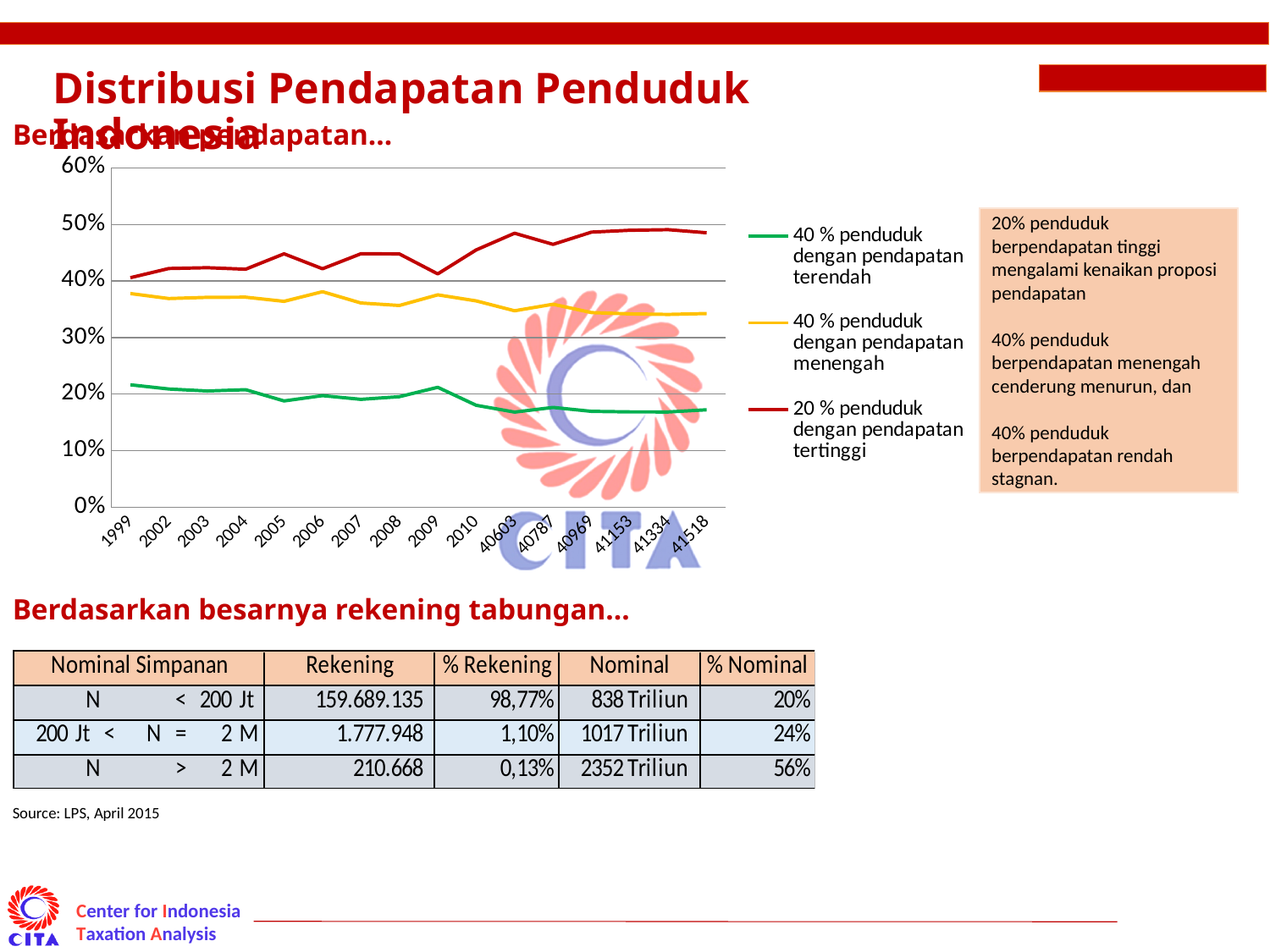
Does the '40 % penduduk dengan pendapatan menengah' series generally rise or fall from left to right along the x axis? Fall Which series has the highest values across the whole chart? 20 % penduduk dengan pendapatan tertinggi Does the '20 % penduduk dengan pendapatan tertinggi' series generally rise or fall from left to right along the x axis? Rise Which series is drawn with the red line in the chart? 20 % penduduk dengan pendapatan tertinggi How many points are plotted along the x axis of the line chart? 16 Is the value for '40 % penduduk dengan pendapatan terendah' in 2010 greater or less than 20%? less What kind of chart is shown on the slide? Line chart How many series does the chart's legend list? 3 Is the value for '20 % penduduk dengan pendapatan tertinggi' in 2005 greater or less than 40%? greater Which series has the lowest values across the whole chart? 40 % penduduk dengan pendapatan terendah Is the value for '40 % penduduk dengan pendapatan menengah' in 1999 greater or less than 40%? less In 2009, which is larger: the value for '20 % penduduk dengan pendapatan tertinggi' or for '40 % penduduk dengan pendapatan menengah'? 20 % penduduk dengan pendapatan tertinggi